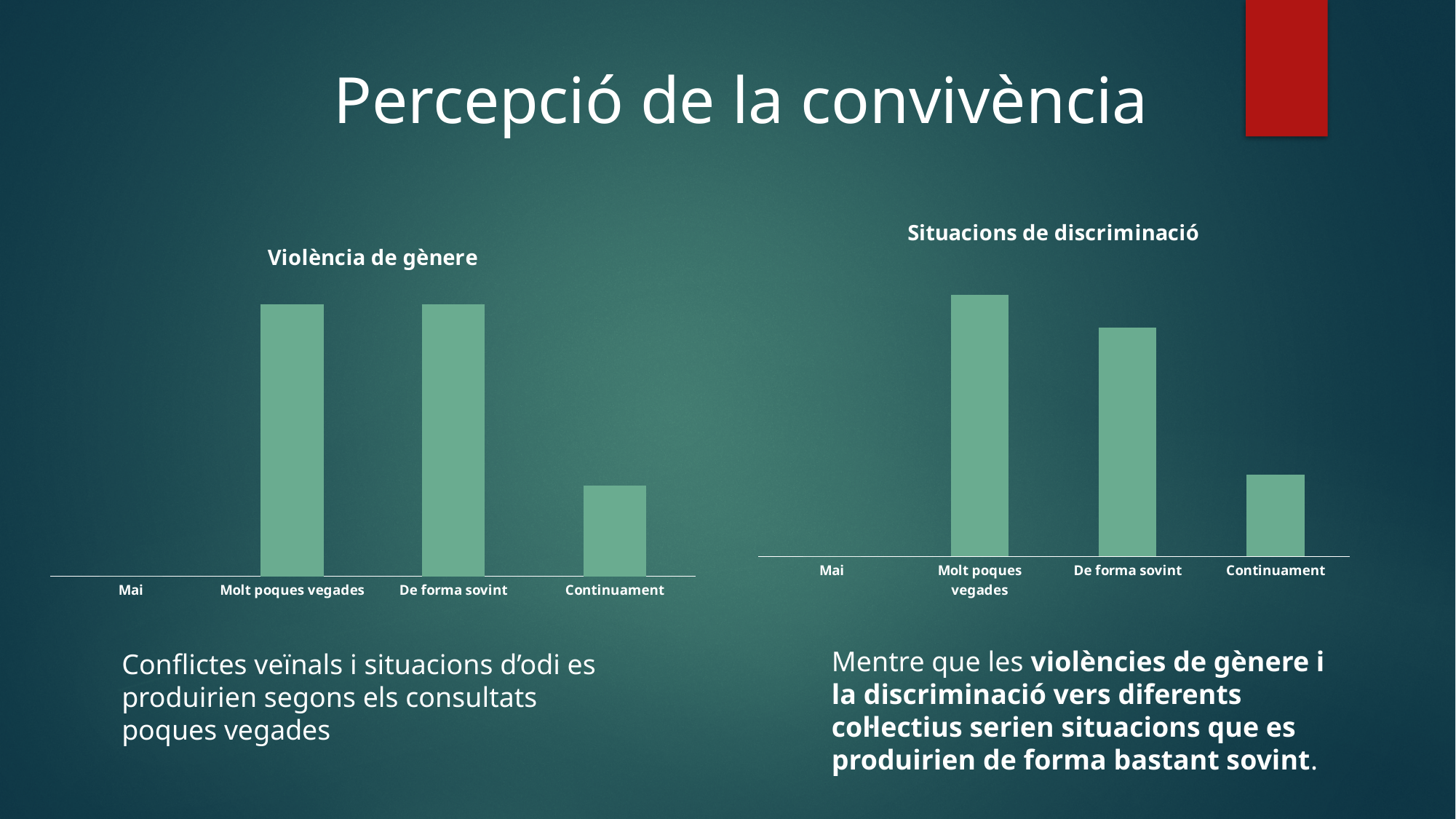
In the 'Violència de gènere' chart, which is larger: 'De forma sovint' or 'Continuament'? De forma sovint In the 'Situacions de discriminació' chart, which category has the lowest value? Mai What kind of chart is the 'Situacions de discriminació' chart? bar chart How many categories are shown on the x axis of the 'Situacions de discriminació' chart? 4 What is the title of the chart on the left side of the slide? Violència de gènere In the 'Situacions de discriminació' chart, which category has the highest bar? Molt poques vegades In the 'Situacions de discriminació' chart, which is larger: 'Molt poques vegades' or 'Continuament'? Molt poques vegades How many categories are shown on the x axis of the 'Violència de gènere' chart? 4 In the 'Situacions de discriminació' chart, which is larger: 'De forma sovint' or 'Continuament'? De forma sovint What kind of chart is the 'Violència de gènere' chart? bar chart In the 'Violència de gènere' chart, which category has the lowest value? Mai What is the title of the chart on the right side of the slide? Situacions de discriminació